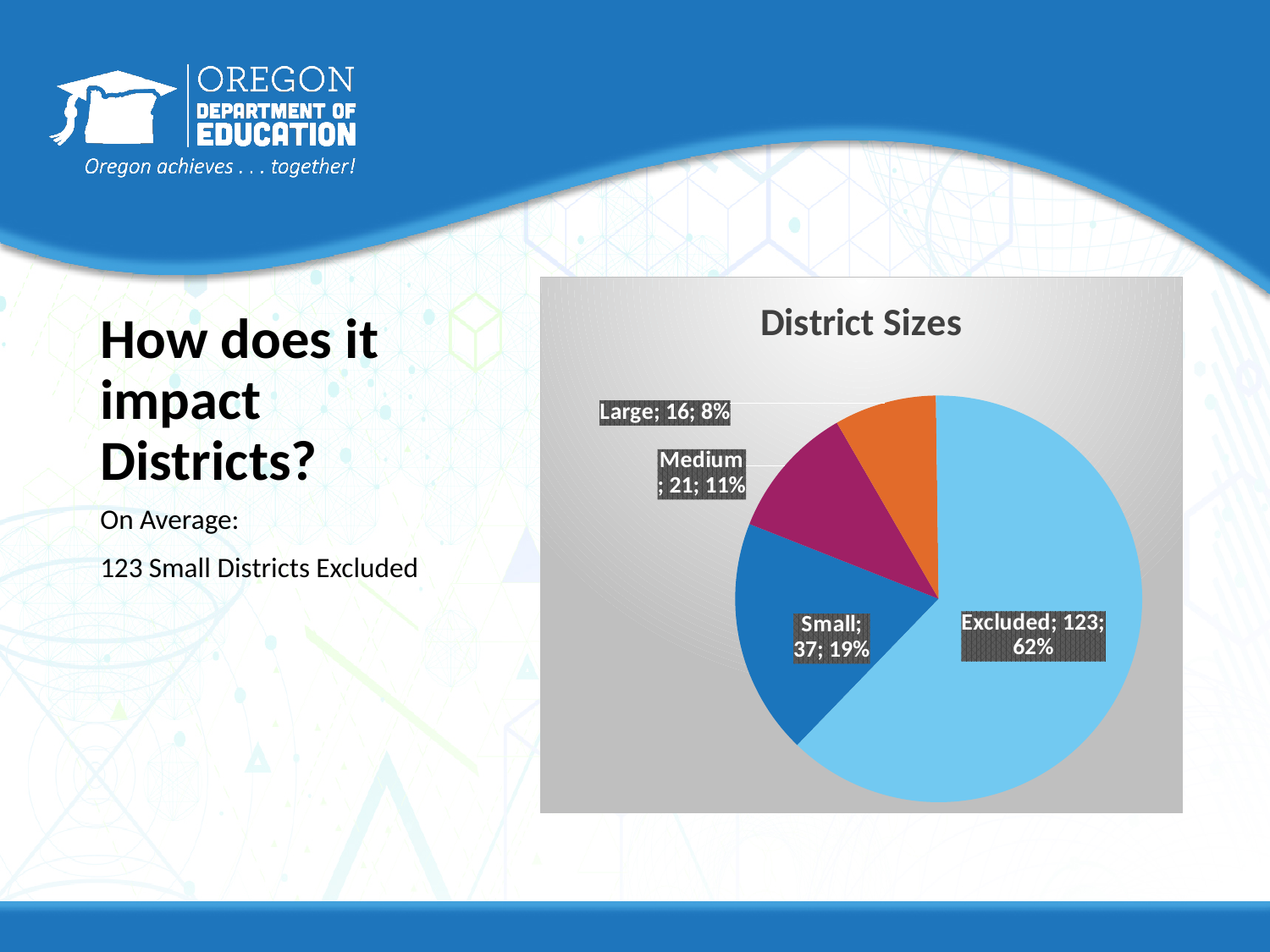
Which category has the largest slice? Excluded How many districts are in the Small slice? 37 How many slices does the pie chart have? 4 What kind of chart is shown on the slide? pie chart What percentage of the pie does the Excluded slice represent? 62% Which category has the smallest slice? Large What percentage of the pie does the Large slice represent? 8% Which has more districts, Medium or Large? Medium How many districts are in the Medium slice? 21 What is the title of the chart? District Sizes How many districts are in the Excluded slice? 123 What is the difference in the number of districts between the Small and Medium slices? 16